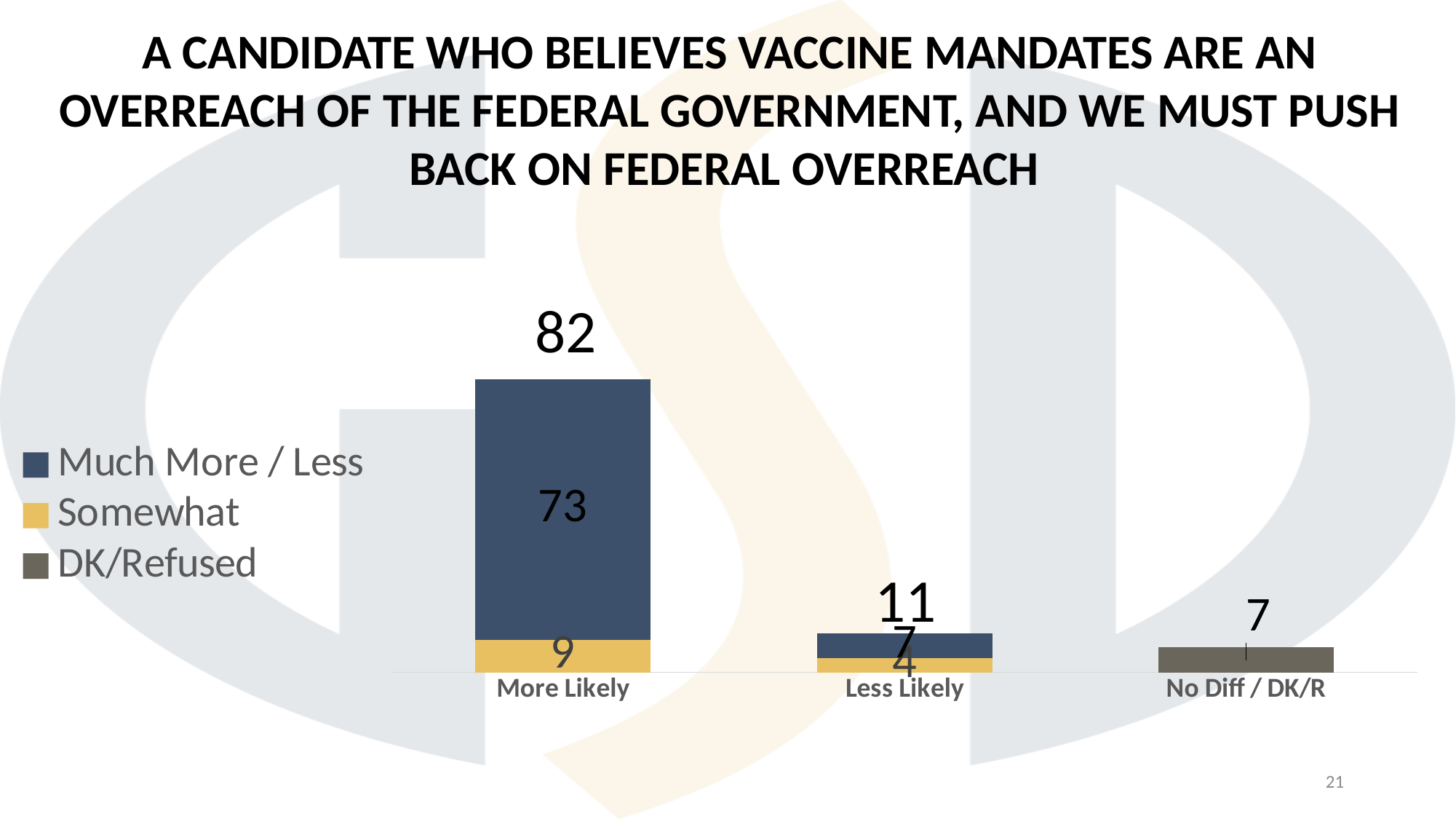
What is the 'Somewhat' value for the More Likely bar? 9 How many categories are shown on the x axis? 3 Which is larger, the 'Somewhat' value for More Likely or the 'Somewhat' value for Less Likely? More Likely Which category has the highest total? More Likely What is the 'Somewhat' value for the Less Likely bar? 4 What is the total shown above the Less Likely bar? 11 What is the 'Much More / Less' value for the Less Likely bar? 7 What is the 'Much More / Less' value for the More Likely bar? 73 What is the value for the No Diff / DK/R bar? 7 What is the total shown above the More Likely bar? 82 How many series does the legend list? 3 What is the difference between the More Likely total and the Less Likely total? 71